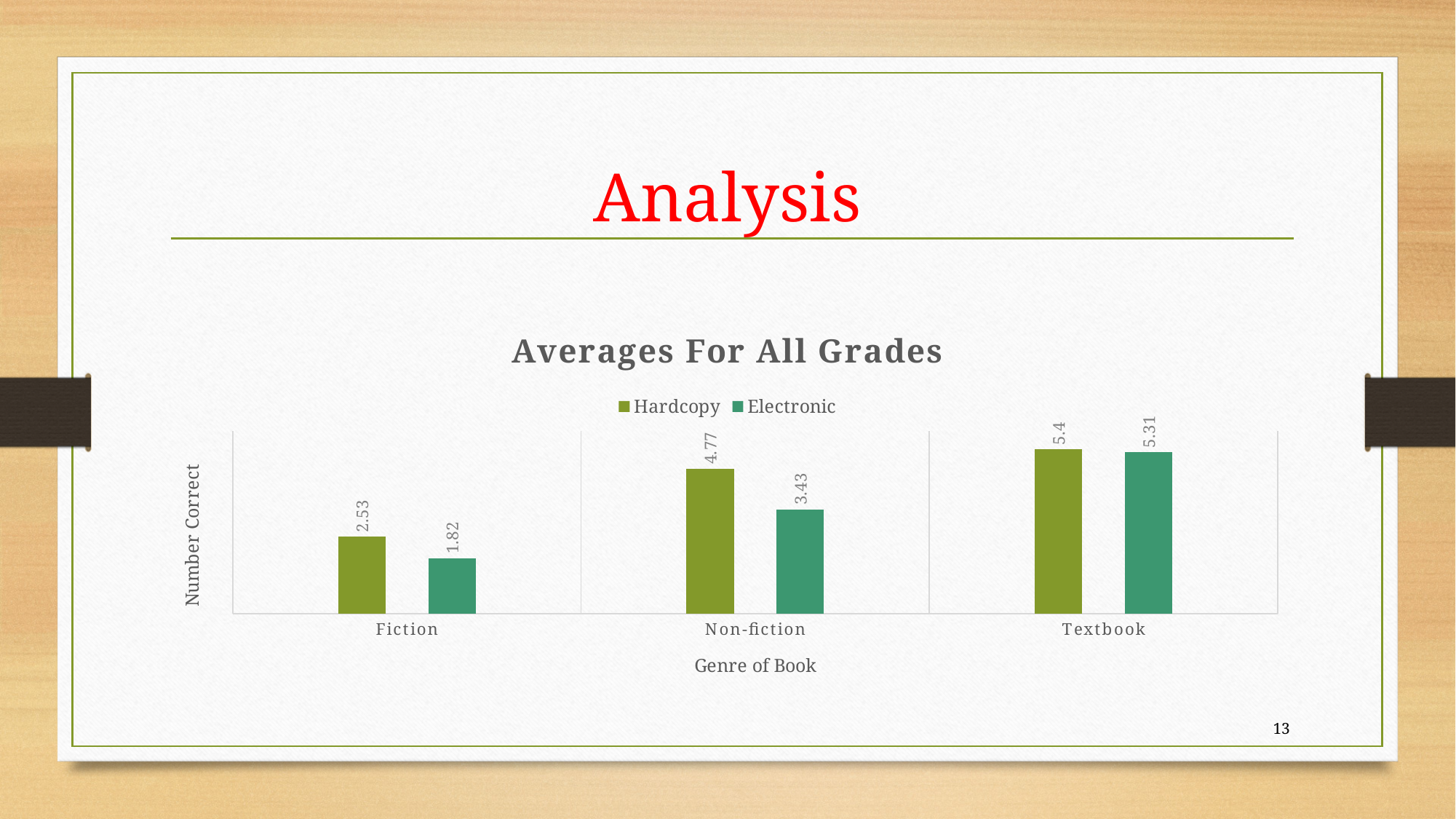
What is the title of the chart? Averages For All Grades What kind of chart is shown? Bar chart What is the Hardcopy value for Textbook? 5.4 Which is larger for Fiction, the Hardcopy value or the Electronic value? Hardcopy What is the difference between the Hardcopy and Electronic values for Non-fiction? 1.34 Which genre has the highest Hardcopy value? Textbook What is the Electronic value for Fiction? 1.82 Which genre has the lowest Electronic value? Fiction What is the Hardcopy value for Fiction? 2.53 How many genres of book are shown on the x axis? 3 How many series does the legend list? 2 What is the Electronic value for Non-fiction? 3.43